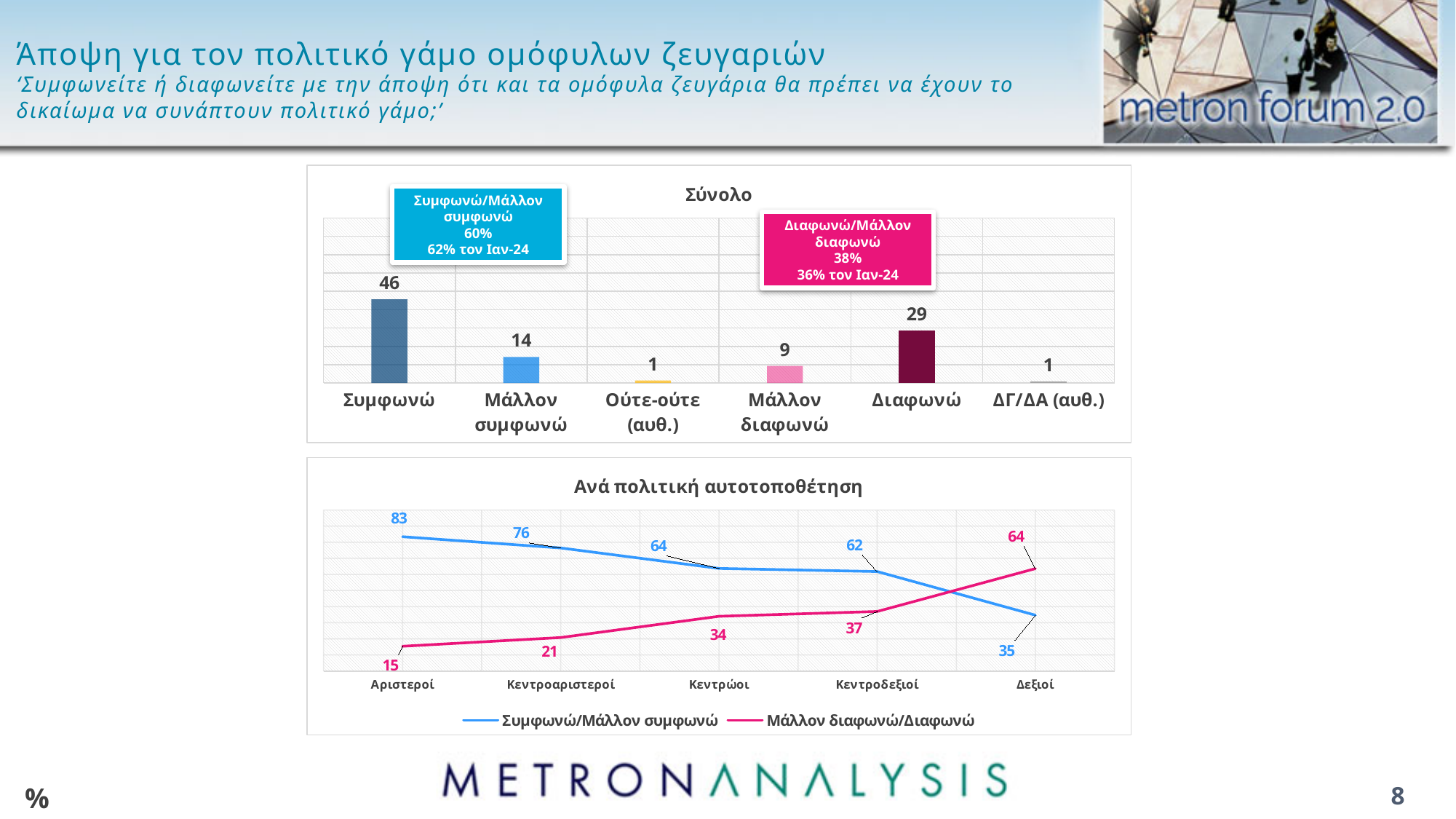
In the 'Σύνολο' chart, what is the difference between 'Συμφωνώ' and 'Διαφωνώ'? 17 In the 'Σύνολο' chart, which category has the highest value? Συμφωνώ In the 'Ανά πολιτική αυτοτοποθέτηση' chart, what is the difference between the two series for 'Κεντρώοι'? 30 In the 'Ανά πολιτική αυτοτοποθέτηση' chart, does the 'Συμφωνώ/Μάλλον συμφωνώ' line rise or fall from 'Αριστεροί' to 'Δεξιοί'? Fall What kind of chart is the 'Σύνολο' chart? Bar chart In the 'Σύνολο' chart, how many categories are shown on the x axis? 6 In the 'Ανά πολιτική αυτοτοποθέτηση' chart, what is the value of 'Συμφωνώ/Μάλλον συμφωνώ' for 'Αριστεροί'? 83 In the 'Ανά πολιτική αυτοτοποθέτηση' chart, which is larger for 'Κεντροδεξιοί': 'Συμφωνώ/Μάλλον συμφωνώ' or 'Μάλλον διαφωνώ/Διαφωνώ'? Συμφωνώ/Μάλλον συμφωνώ In the 'Σύνολο' chart, what is the value for 'Συμφωνώ'? 46 In the 'Ανά πολιτική αυτοτοποθέτηση' chart, how many series does the legend list? 2 In the 'Σύνολο' chart, what is the value for 'Διαφωνώ'? 29 In the 'Ανά πολιτική αυτοτοποθέτηση' chart, what is the value of 'Μάλλον διαφωνώ/Διαφωνώ' for 'Δεξιοί'? 64